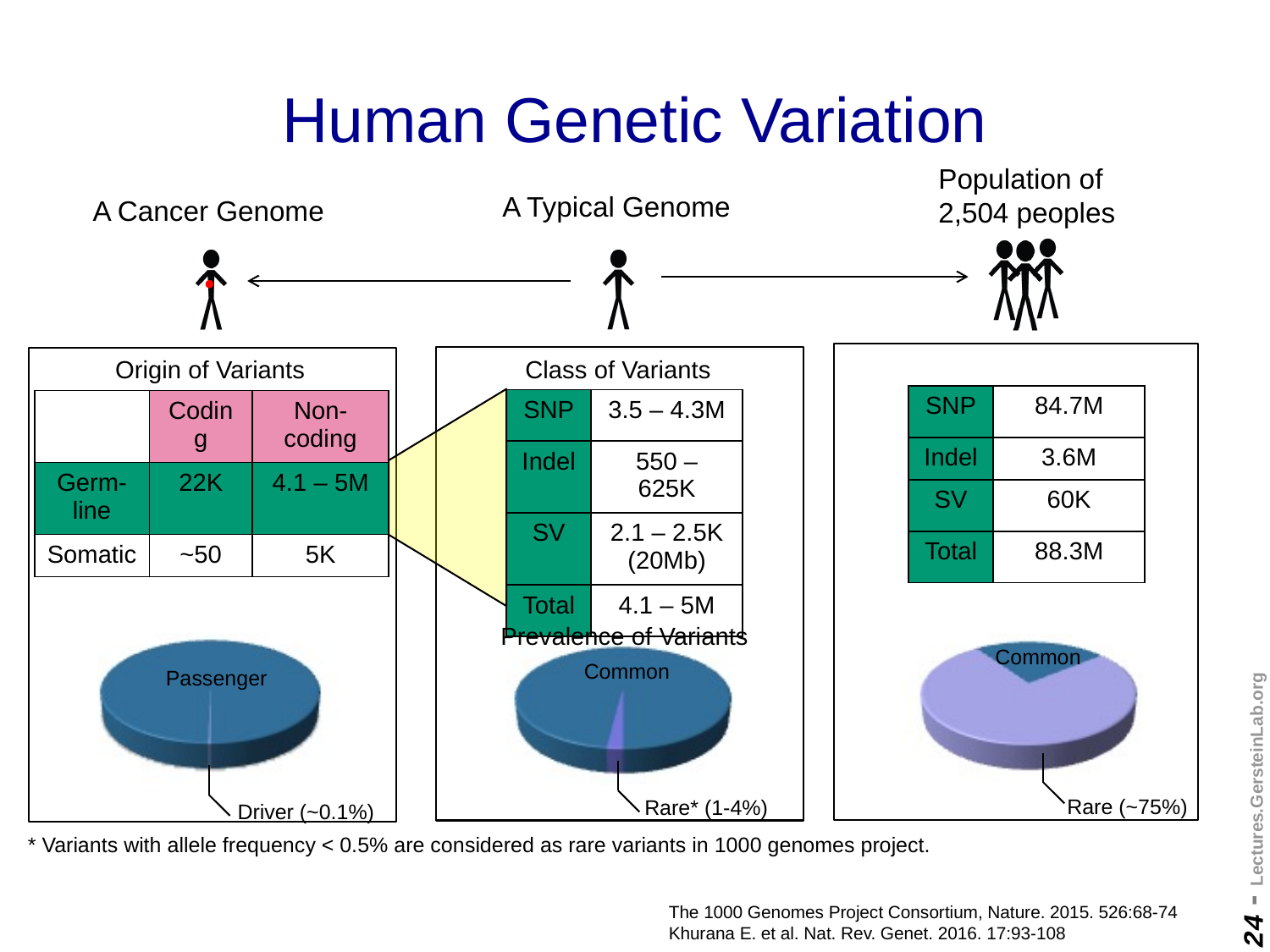
In the 'A Cancer Genome' pie chart, which slice is larger, Passenger or Driver? Passenger In the 'A Cancer Genome' pie chart, what is the label printed for the small slice? Driver (~0.1%) In the 'Population of 2,504 peoples' pie chart, how many slices are there? 2 In the 'A Typical Genome' pie chart, how many slices are there? 2 In the 'A Typical Genome' pie chart, what is the label printed for the small slice? Rare* (1-4%) In the 'Population of 2,504 peoples' pie chart, what is the label printed for the large slice? Rare (~75%) What kind of chart is shown in the 'Population of 2,504 peoples' box? pie chart What is the title printed above the pie chart in the 'A Typical Genome' box? Prevalence of Variants In the 'Population of 2,504 peoples' pie chart, which slice is larger, Common or Rare? Rare In the 'A Cancer Genome' pie chart, how many slices are there? 2 In the 'A Typical Genome' pie chart, which slice is larger, Common or Rare? Common In the 'A Cancer Genome' box, what kind of chart is shown below the Origin of Variants table? pie chart